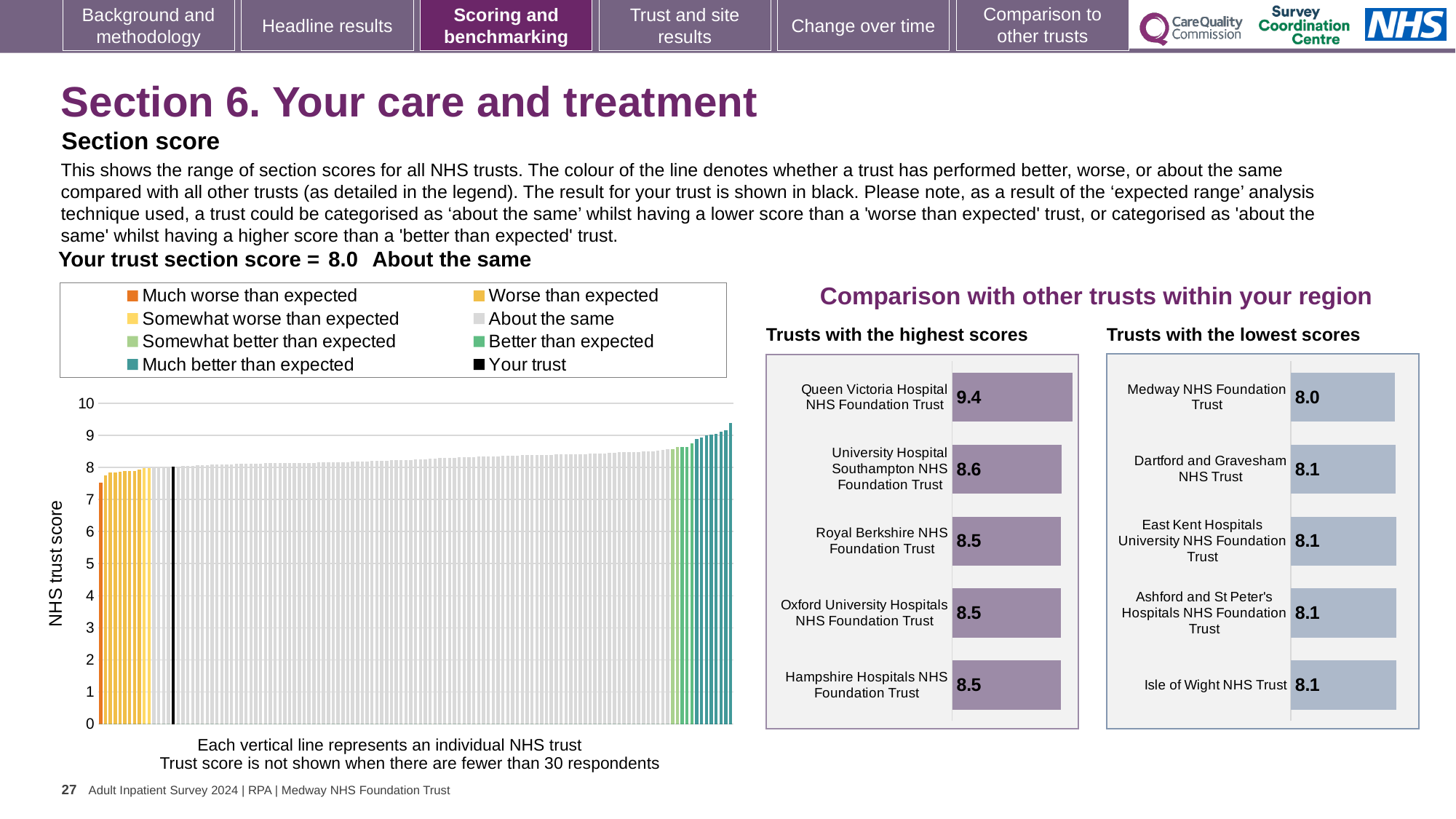
What kind of chart is the NHS trust score chart on the left of the slide? Bar chart In the 'Trusts with the highest scores' chart, which trust has the highest score? Queen Victoria Hospital NHS Foundation Trust How many entries does the legend of the NHS trust score chart on the left list? 8 In the 'Trusts with the highest scores' chart, what is the score for University Hospital Southampton NHS Foundation Trust? 8.6 How many trusts are shown in the 'Trusts with the lowest scores' chart? 5 In the NHS trust score chart on the left, do the bar values rise or fall from left to right? Rise In the 'Trusts with the highest scores' chart, what is the score for Queen Victoria Hospital NHS Foundation Trust? 9.4 Which has a higher score: Queen Victoria Hospital NHS Foundation Trust in the highest-scores chart or Medway NHS Foundation Trust in the lowest-scores chart? Queen Victoria Hospital NHS Foundation Trust In the 'Trusts with the lowest scores' chart, which trust has the lowest score? Medway NHS Foundation Trust In the 'Trusts with the lowest scores' chart, what is the difference between the scores of Isle of Wight NHS Trust and Medway NHS Foundation Trust? 0.1 In the 'Trusts with the highest scores' chart, what is the difference between the scores of Queen Victoria Hospital NHS Foundation Trust and University Hospital Southampton NHS Foundation Trust? 0.8 In the 'Trusts with the lowest scores' chart, what is the score for Medway NHS Foundation Trust? 8.0